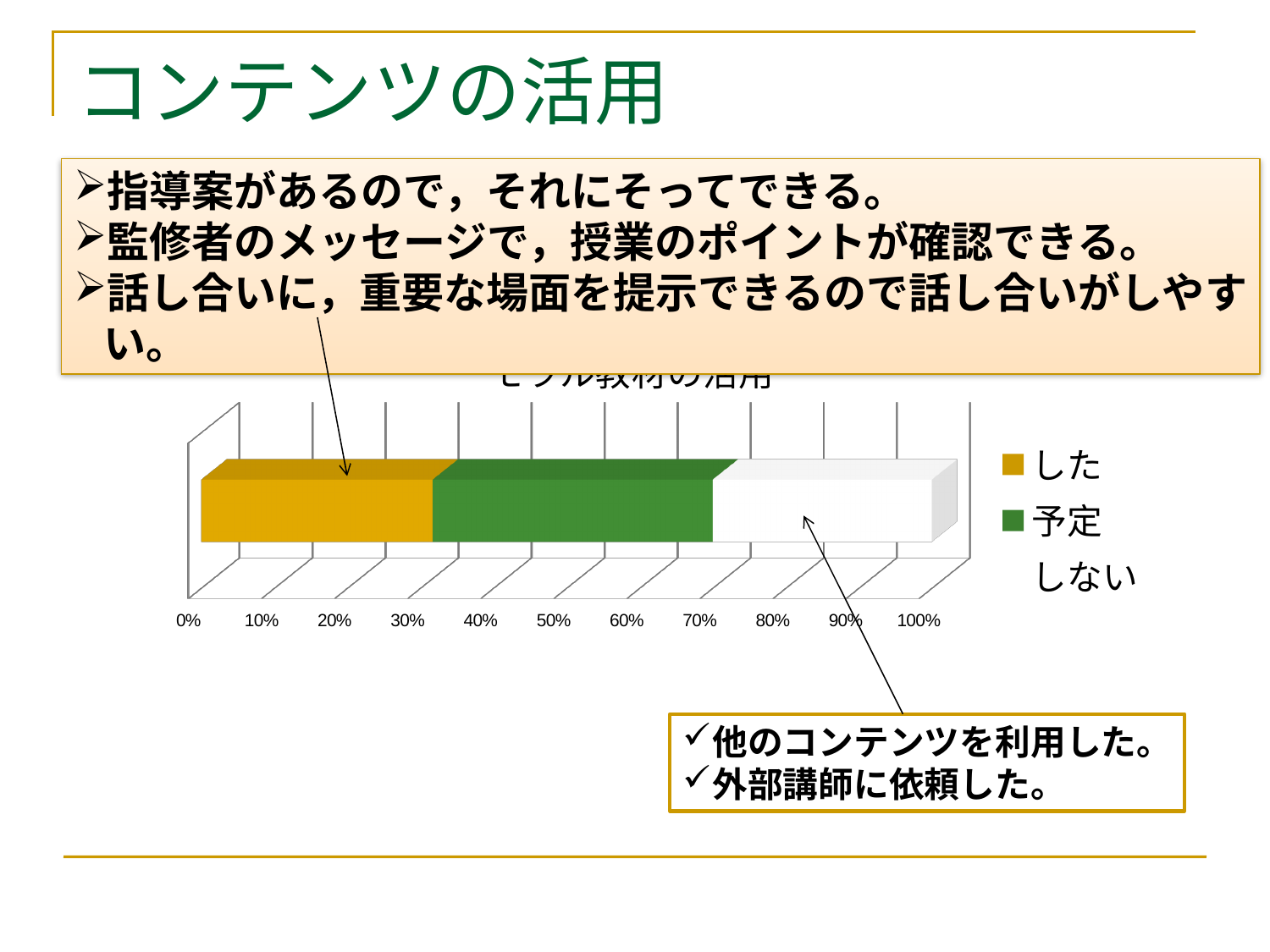
Is the value for した greater or less than 40%? less Which colour represents the series した in the chart? gold (yellow-orange) Is the value for 予定 greater or less than 20%? greater Is the value for した greater or less than 20%? greater What kind of chart is shown on the slide? bar chart What are the three legend entries of the chart? した, 予定, しない How many bars are plotted in the chart? 1 What is the maximum value shown on the chart's horizontal axis? 100% How many series does the chart's legend list? 3